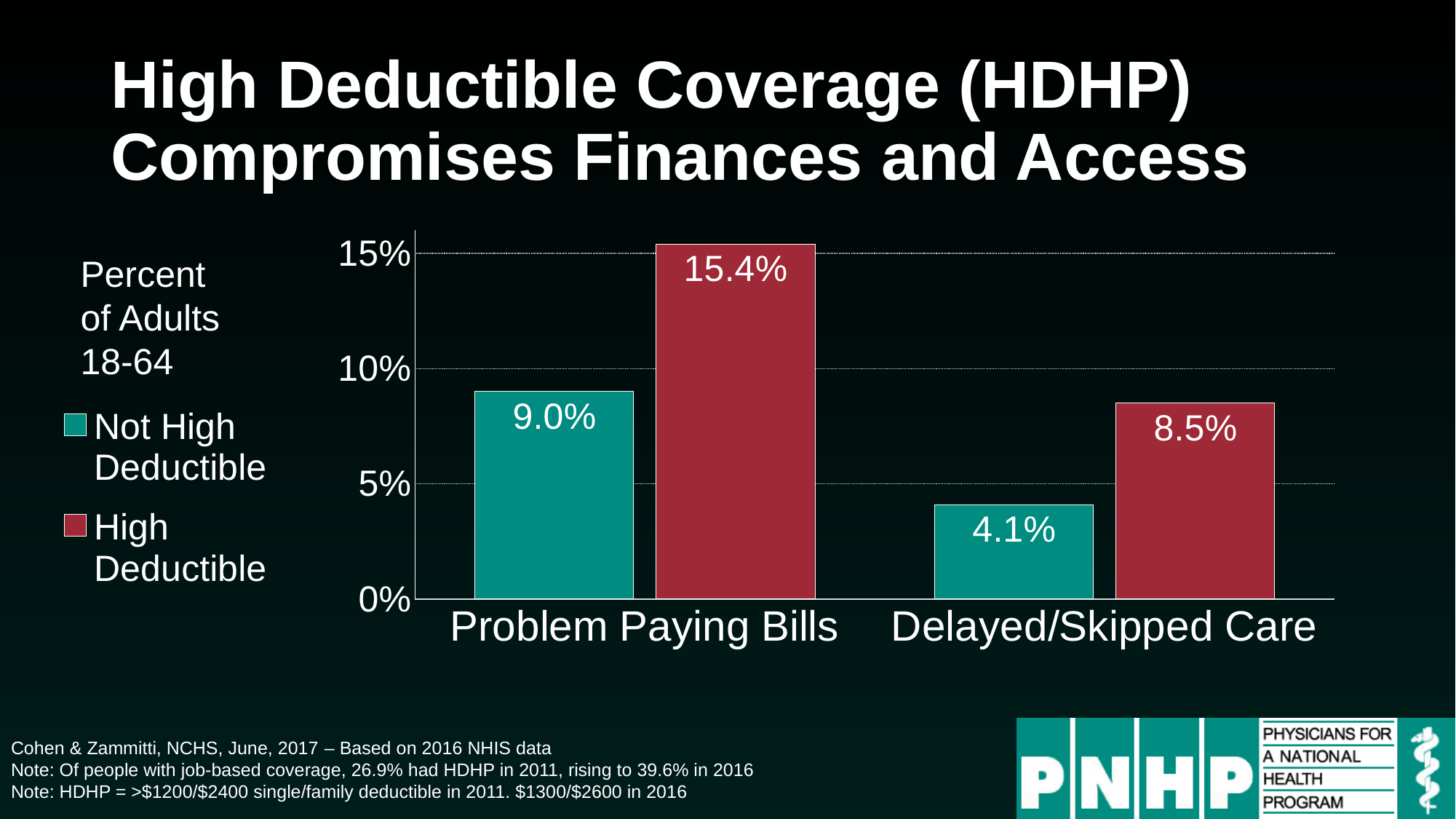
Which bar in the chart has the lowest value? Not High Deductible, Delayed/Skipped Care What percent of adults with Not High Deductible coverage reported Delayed/Skipped Care? 4.1% What percent of adults with High Deductible coverage had a Problem Paying Bills? 15.4% What is the difference between the High Deductible and Not High Deductible values for Problem Paying Bills? 6.4% What is the difference between the High Deductible and Not High Deductible values for Delayed/Skipped Care? 4.4% What kind of chart is shown on the slide? Bar chart For Delayed/Skipped Care, which series has the larger value: High Deductible or Not High Deductible? High Deductible What percent of adults with High Deductible coverage reported Delayed/Skipped Care? 8.5% How many categories are shown on the x axis of the chart? 2 What percent of adults with Not High Deductible coverage had a Problem Paying Bills? 9.0% Which bar in the chart has the highest value? High Deductible, Problem Paying Bills How many series does the legend list? 2